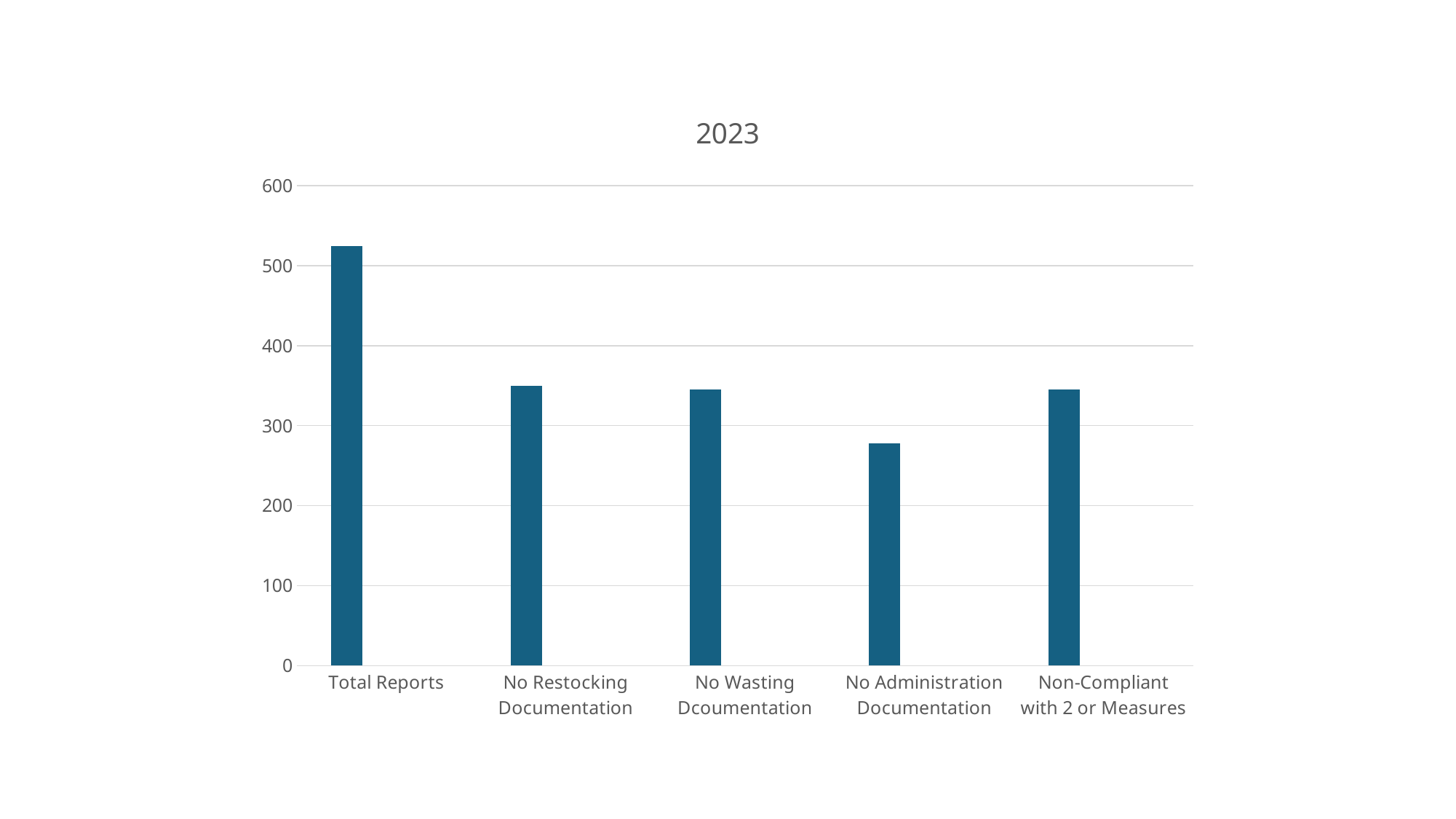
Is the value for Non-Compliant with 2 or Measures greater or less than 300? greater Is the value for No Administration Documentation greater or less than 300? less Is the value for Total Reports greater or less than 500? greater Which is larger, the value for Total Reports or the value for No Restocking Documentation? Total Reports What is the highest value shown on the vertical axis of the chart? 600 Which is larger, the value for No Administration Documentation or the value for Non-Compliant with 2 or Measures? Non-Compliant with 2 or Measures How many categories are shown on the x axis of the chart? 5 What kind of chart is shown on the slide? bar chart Which category has the lowest value in the chart? No Administration Documentation Which category has the highest value in the chart? Total Reports What is the title of the chart? 2023